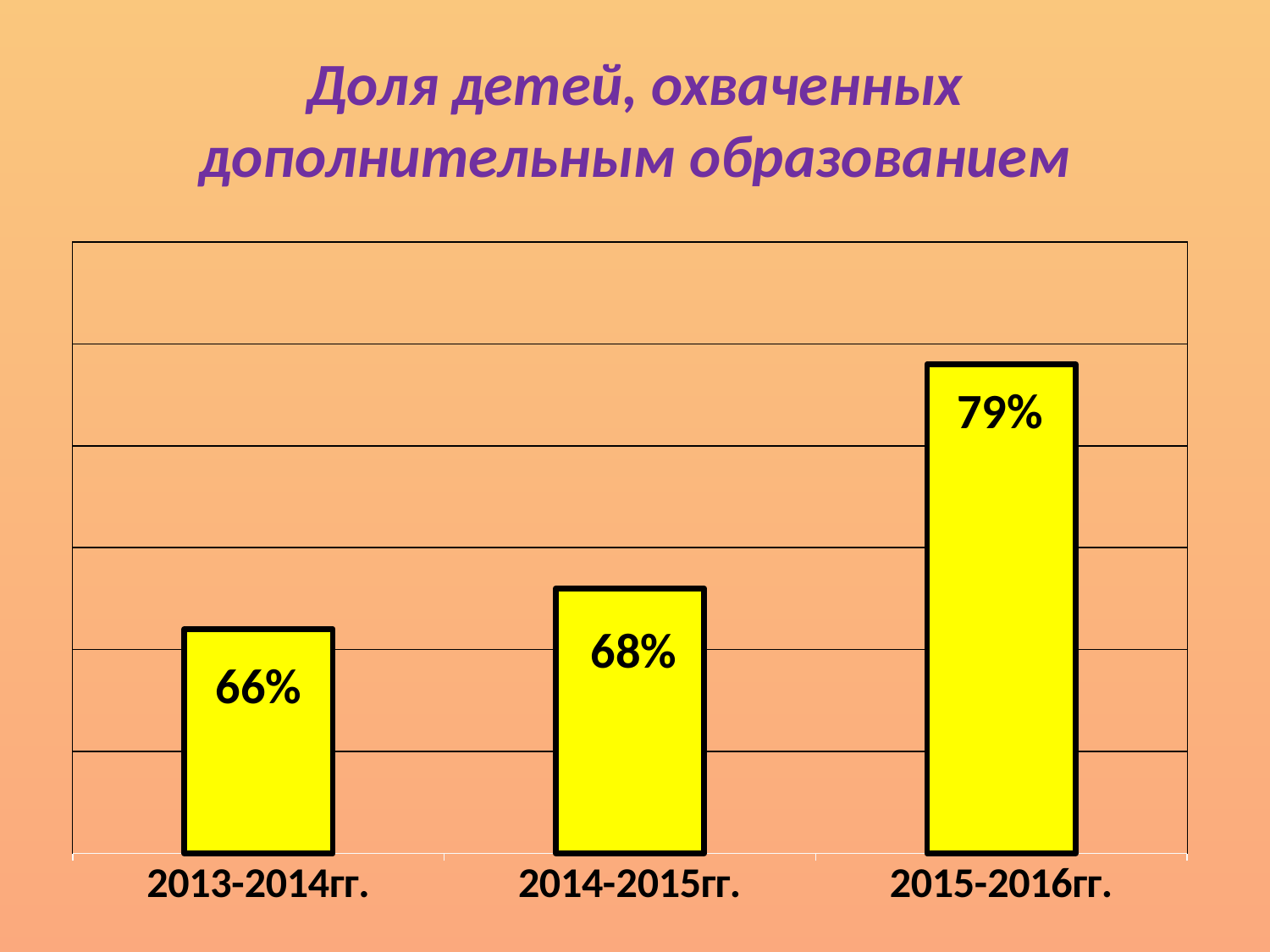
What is the value for 2013-2014гг.? 66% What kind of chart is shown on the slide? bar chart Which period has the highest value? 2015-2016гг. What is the difference between the values for 2014-2015гг. and 2013-2014гг.? 2% Which is larger, the value for 2015-2016гг. or the value for 2014-2015гг.? 2015-2016гг. What is the value for 2014-2015гг.? 68% Do the values rise or fall from 2013-2014гг. to 2015-2016гг.? rise What is the difference between the values for 2015-2016гг. and 2013-2014гг.? 13% What is the title of the chart? Доля детей, охваченных дополнительным образованием What is the value for 2015-2016гг.? 79% How many periods are shown on the x axis? 3 Which period has the lowest value? 2013-2014гг.